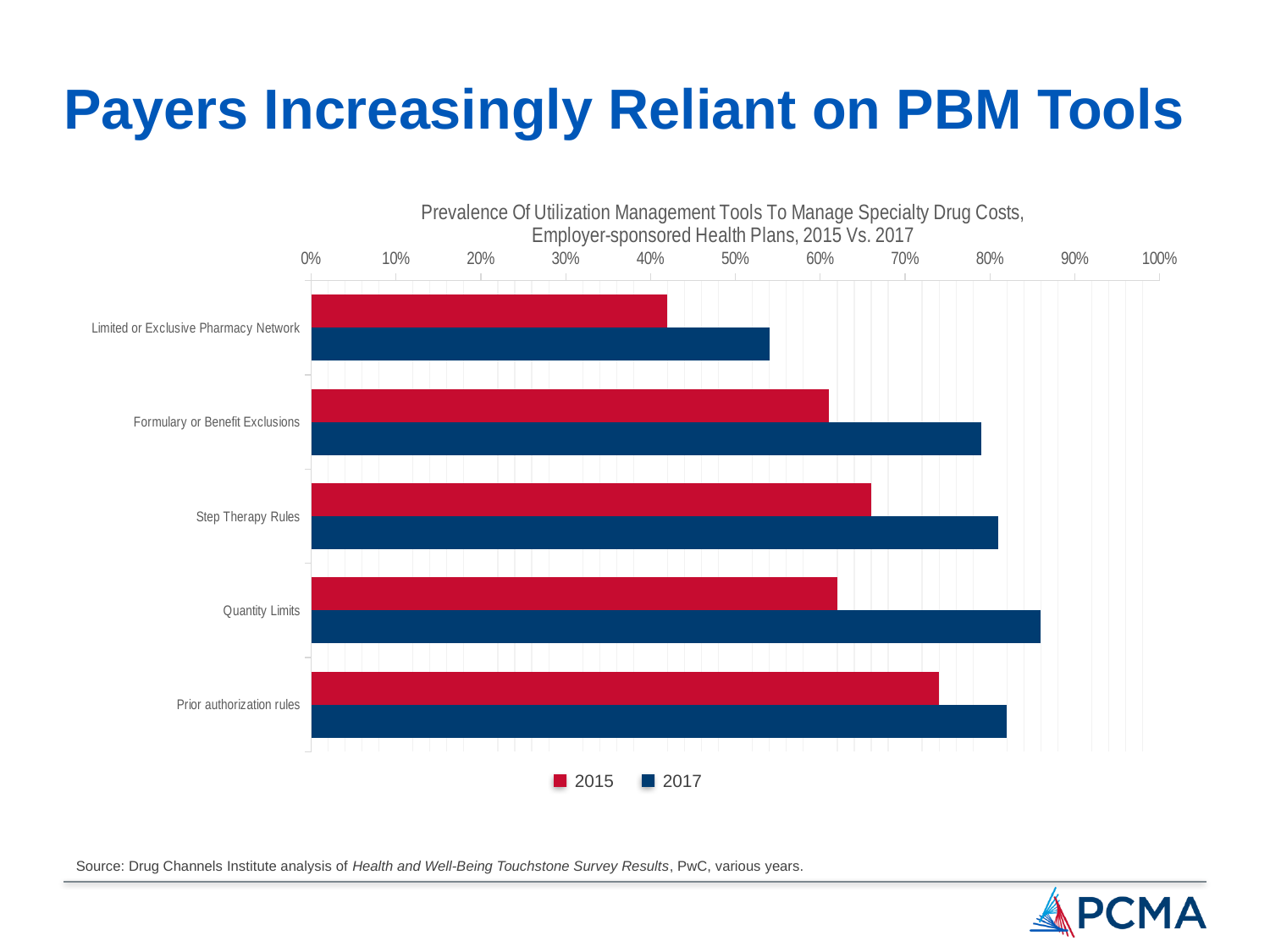
Which series is shown in red in the legend? 2015 For Step Therapy Rules, which year has the larger value, 2015 or 2017? 2017 Which category has the lowest 2017 value? Limited or Exclusive Pharmacy Network Is the 2017 value for Formulary or Benefit Exclusions greater or less than 70%? greater Which category has the lowest 2015 value? Limited or Exclusive Pharmacy Network Which category has the highest 2017 value? Quantity Limits Which category has the highest 2015 value? Prior authorization rules Is the 2017 value for Quantity Limits greater or less than 80%? greater How many series does the legend list? 2 How many utilization management tools (categories) are shown in the chart? 5 Is the 2015 value for Limited or Exclusive Pharmacy Network greater or less than 50%? less What kind of chart is shown on the slide? Bar chart